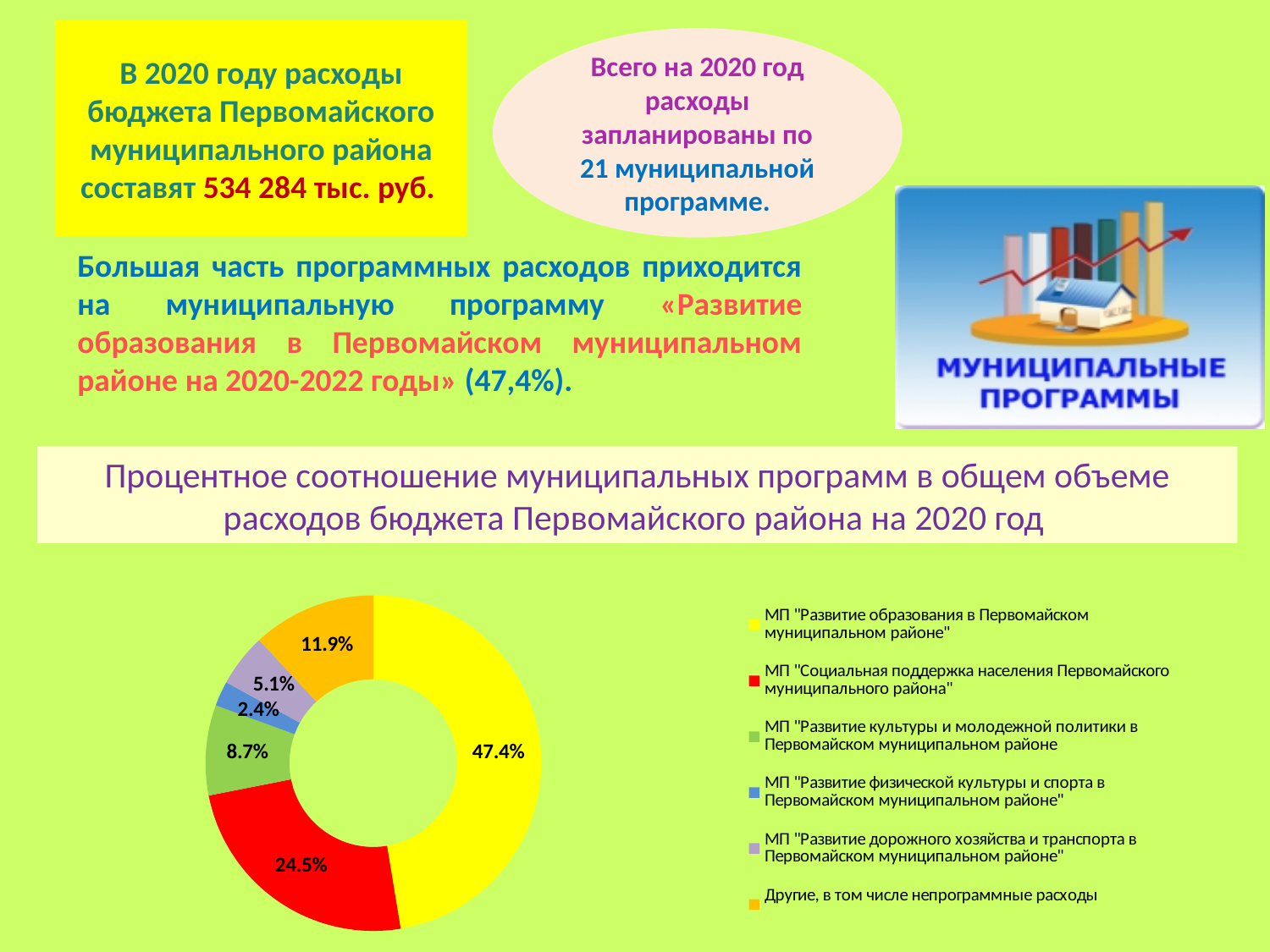
What share is shown for МП "Развитие дорожного хозяйства и транспорта в Первомайском муниципальном районе"? 5.1% Which colour represents МП "Социальная поддержка населения Первомайского муниципального района" in the chart? Red What share is shown for МП "Развитие культуры и молодежной политики в Первомайском муниципальном районе"? 8.7% What share is shown for "Другие, в том числе непрограммные расходы"? 11.9% What share is shown for МП "Развитие физической культуры и спорта в Первомайском муниципальном районе"? 2.4% Which category has the smallest share in the chart? МП "Развитие физической культуры и спорта в Первомайском муниципальном районе" What is the difference between the share for education (47.4%) and the share for social support (24.5%)? 22.9% What type of chart is shown on the slide? Doughnut (pie) chart What share of the 2020 budget expenditure goes to the programme МП "Развитие образования в Первомайском муниципальном районе"? 47.4% Which category has the largest share in the chart? МП "Развитие образования в Первомайском муниципальном районе" What share is shown for МП "Социальная поддержка населения Первомайского муниципального района"? 24.5% How many categories (slices) does the chart show? 6